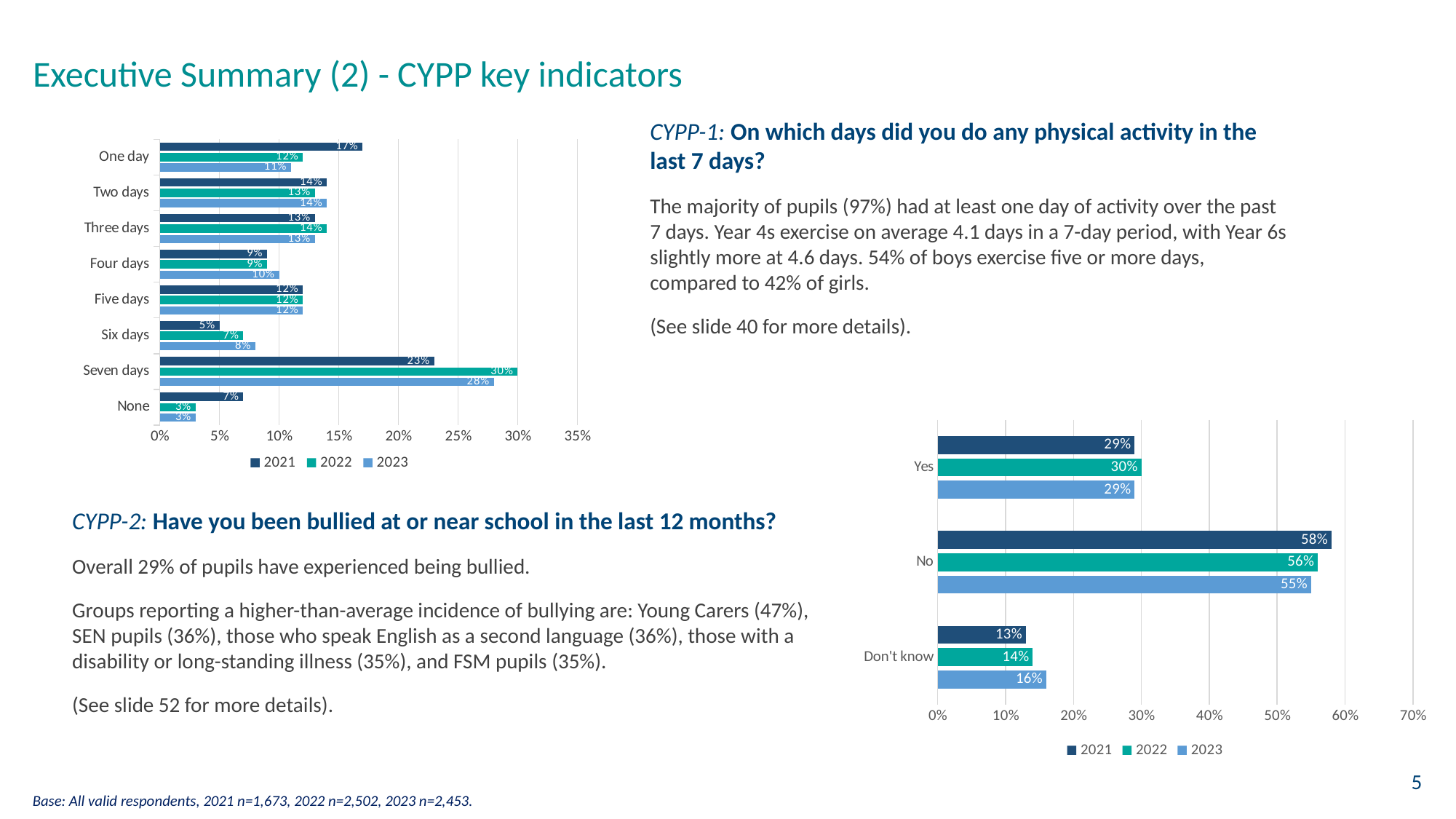
What type of chart is the left chart? Bar chart In the bottom-right chart, how many series does the legend list? 3 In the left chart, what is the 2022 value for Seven days? 30% In the bottom-right chart, what is the 2022 value for Yes? 30% In the left chart, how many categories are shown on the vertical axis? 8 In the bottom-right chart, what is the difference between the 2021 and 2023 values for No? 3% In the left chart, which category has the lowest 2023 value? None In the bottom-right chart, which category has the highest 2021 value? No In the bottom-right chart, what is the 2023 value for Don't know? 16% In the left chart, is the 2021 value for Seven days larger than the 2022 value for Seven days? No In the left chart, what is the 2021 value for One day? 17% In the bottom-right chart, what is the 2021 value for No? 58%